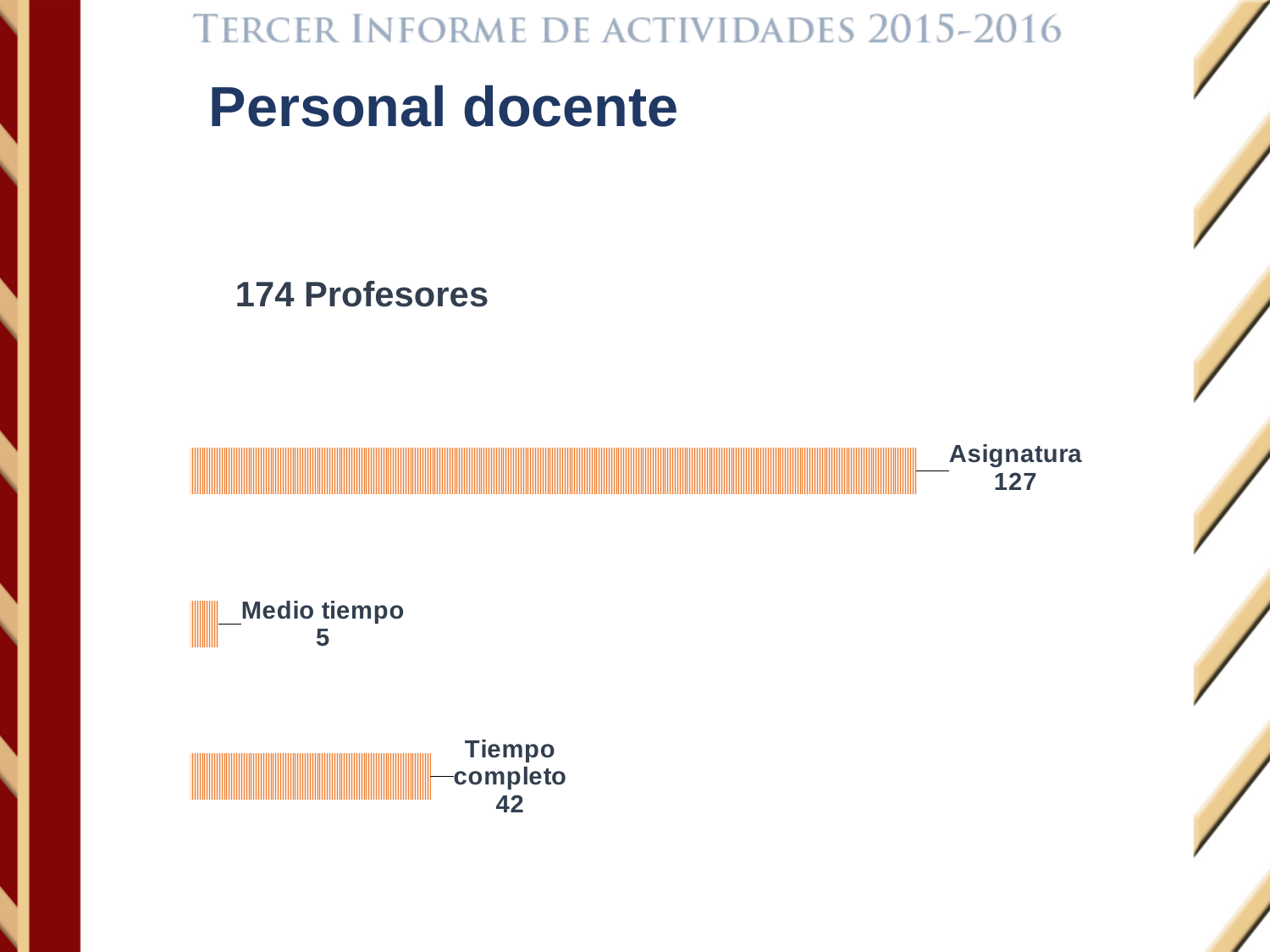
What is the title of the slide containing the chart? Personal docente What is the value for Asignatura? 127 What kind of chart is shown on the slide? bar chart What is the value for Tiempo completo? 42 Which is larger, the value for Tiempo completo or the value for Medio tiempo? Tiempo completo How many categories are shown in the chart? 3 Which category has the highest value? Asignatura What is the total of the three values shown in the chart? 174 What is the value for Medio tiempo? 5 What is the difference between the values for Asignatura and Tiempo completo? 85 What is the difference between the values for Tiempo completo and Medio tiempo? 37 Which category has the lowest value? Medio tiempo